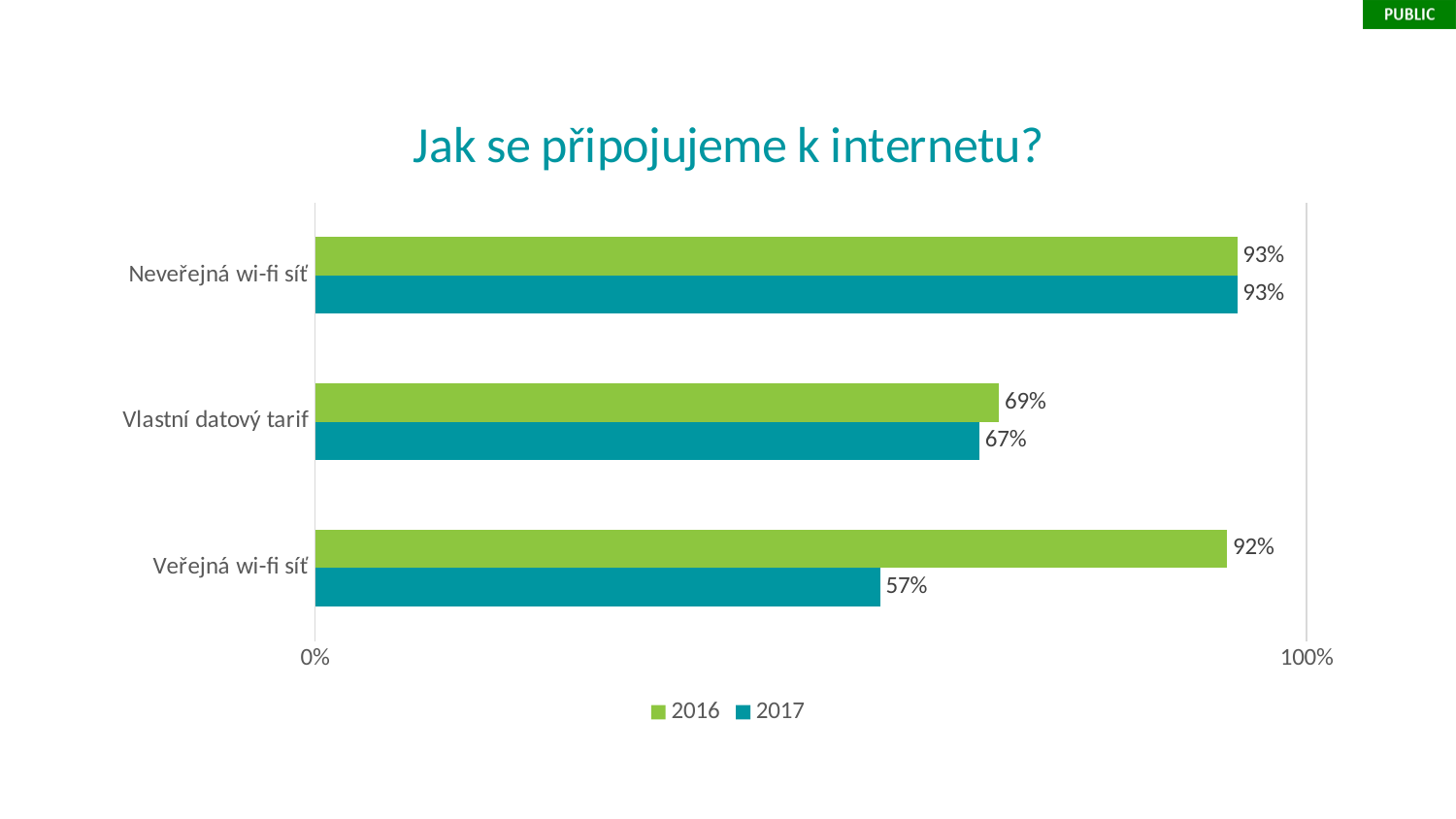
What is the value for Veřejná wi-fi síť in 2016? 92% Which category has the lowest value in 2017? Veřejná wi-fi síť How many series does the legend list? 2 How many categories are shown on the chart? 3 What is the value for Veřejná wi-fi síť in 2017? 57% Which category has the highest value in 2017? Neveřejná wi-fi síť What kind of chart is shown on the slide? Bar chart What is the difference between the 2016 and 2017 values for Vlastní datový tarif? 2% What is the value for Neveřejná wi-fi síť in 2017? 93% What is the difference between the 2016 and 2017 values for Veřejná wi-fi síť? 35% Which is larger for Veřejná wi-fi síť: the 2016 value or the 2017 value? 2016 What is the value for Vlastní datový tarif in 2016? 69%